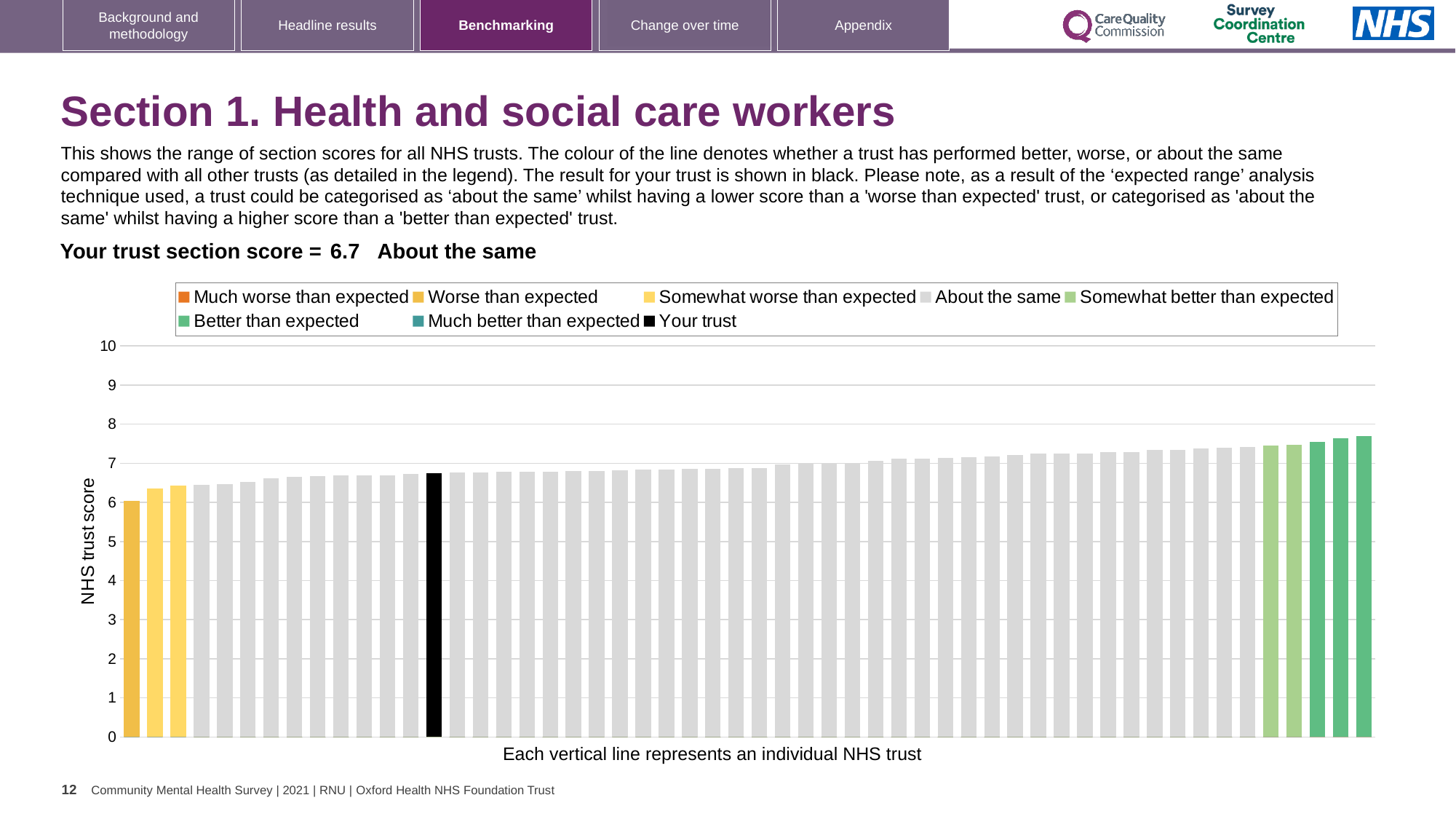
What is the label on the vertical axis of the chart? NHS trust score What is the section score for your trust shown on the slide? 6.7 What kind of chart is shown on the slide? bar chart Is the value of the leftmost (lowest) bar greater or less than 7? less Do the bar values rise or fall moving from left to right along the x axis? rise How many bars are coloured as 'Somewhat worse than expected' (yellow)? 2 Is the value of the rightmost (highest) bar greater or less than 7? greater What colour is used for the bar representing your trust? black How many entries does the chart legend list? 8 Is the value for your trust (the black bar) greater or less than 6? greater Is the leftmost bar higher or lower than the black bar for your trust? lower Which performance category is your trust placed in for this section? About the same